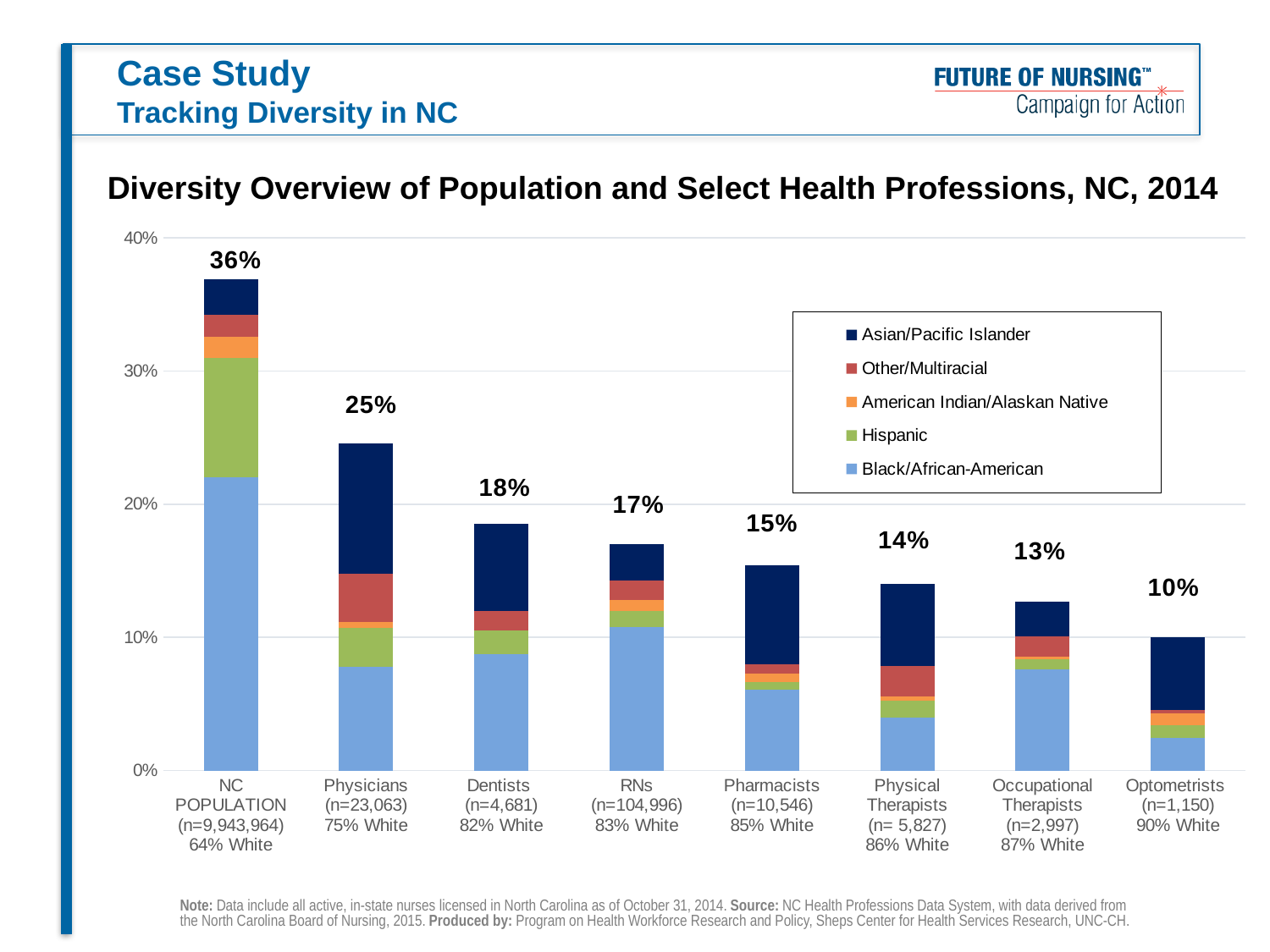
What kind of chart is shown on the slide? Stacked bar chart What is the difference between the total for Dentists and the total for Optometrists? 8% How many categories are shown on the x axis? 8 What is the difference between the total for NC POPULATION and the total for Physicians? 11% What is the total value labeled above the RNs bar? 17% Which category has the lowest total value? Optometrists What is the total value labeled above the Optometrists bar? 10% Is the Black/African-American value for NC POPULATION greater or less than 20%? greater Which category has the highest total value? NC POPULATION How many series does the legend list? 5 Which has a larger total value, Pharmacists or Physical Therapists? Pharmacists What is the total non-white share shown above the bar for Physicians? 25%